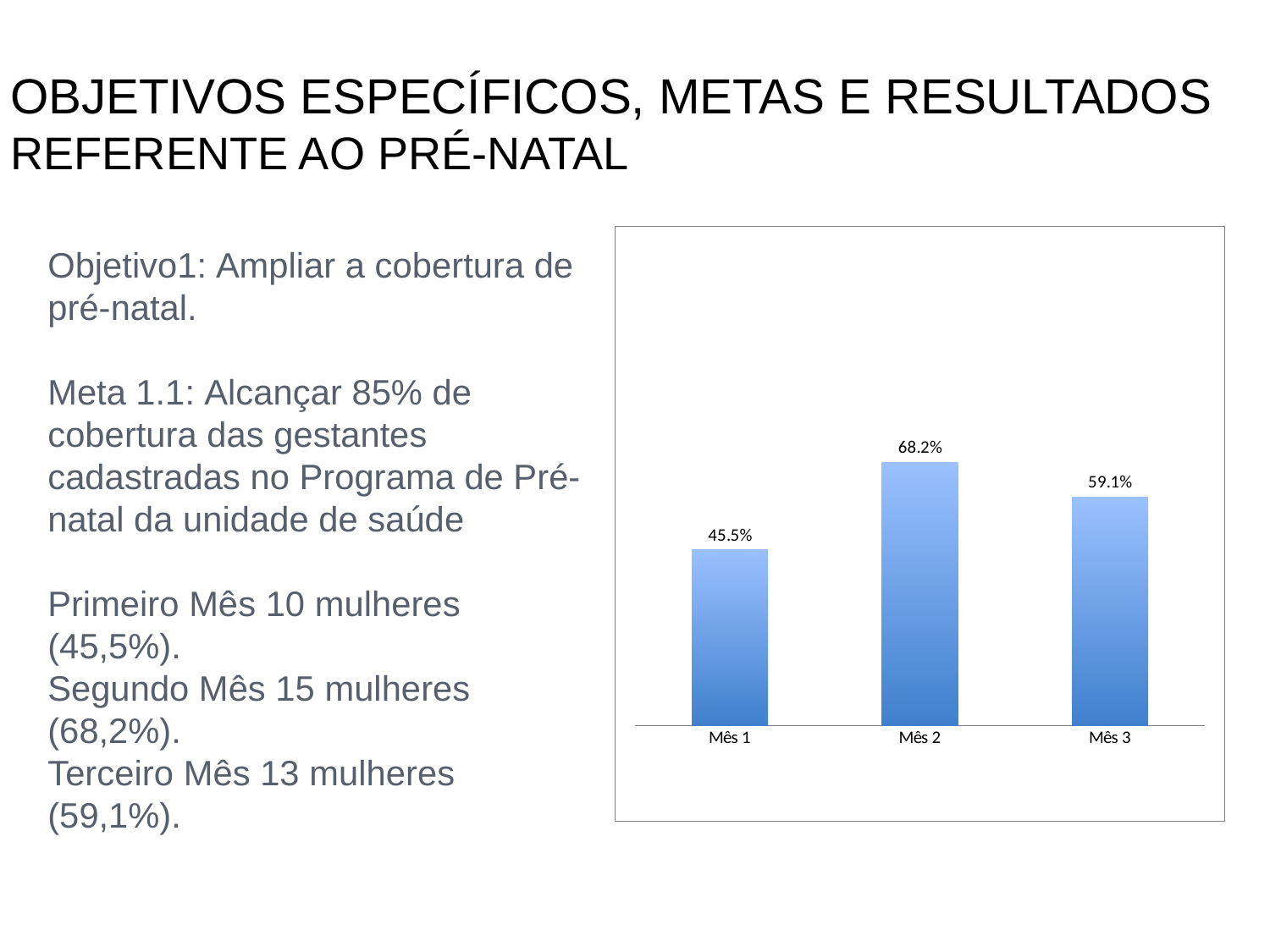
Does the value rise or fall from Mês 2 to Mês 3? Fall How many months are shown on the chart? 3 What is the difference between the values for Mês 2 and Mês 1? 22.7% What is the value for Mês 1? 45.5% What is the value for Mês 3? 59.1% Which is larger, the value for Mês 3 or the value for Mês 1? Mês 3 Does the value rise or fall from Mês 1 to Mês 2? Rise What kind of chart is shown on the slide? Bar chart What is the difference between the values for Mês 2 and Mês 3? 9.1% Which month has the highest value? Mês 2 What is the value for Mês 2? 68.2% Which month has the lowest value? Mês 1